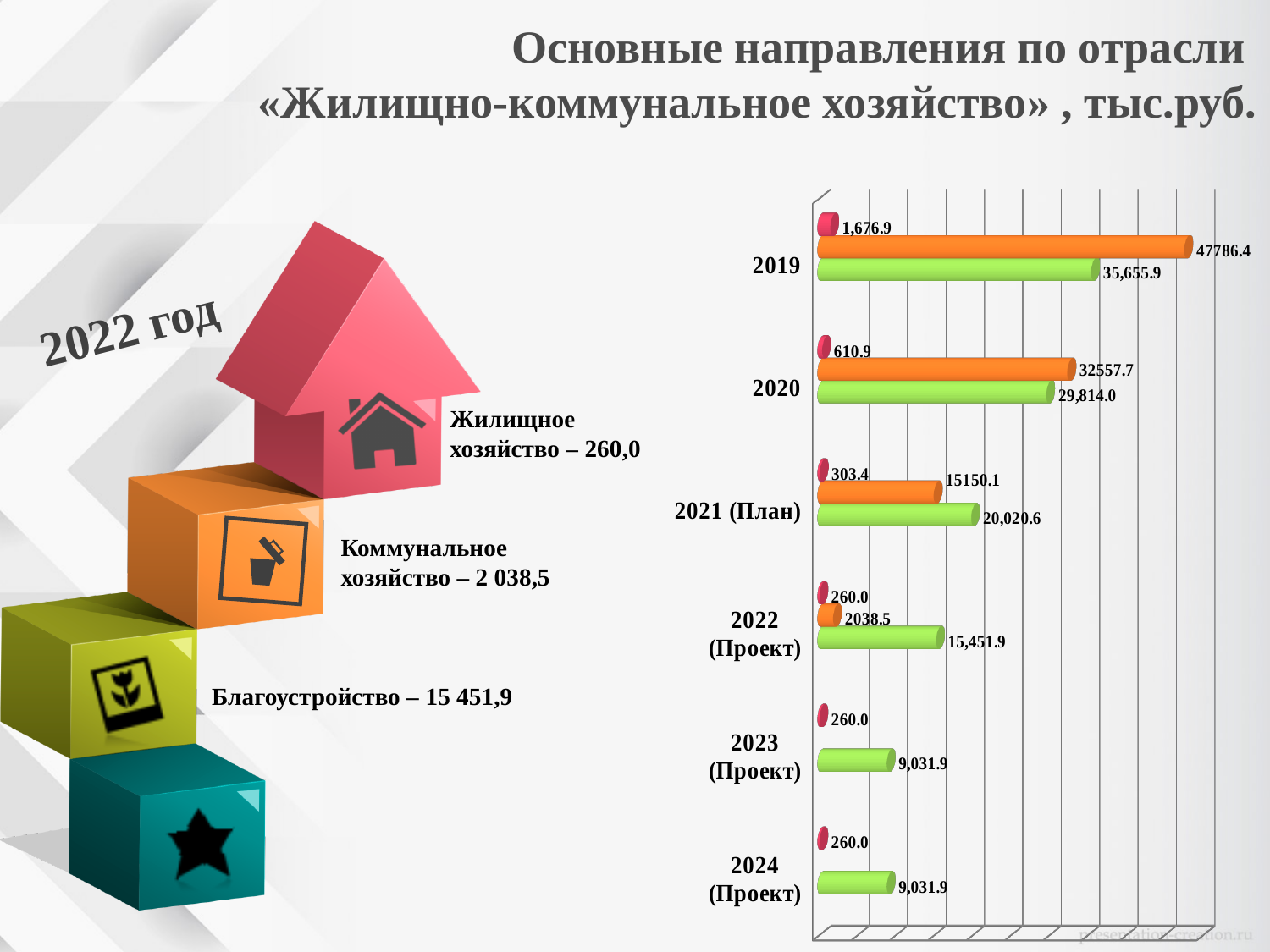
What is the value of the green bar for 2024 (Проект)? 9,031.9 What is the value of the orange bar for 2019? 47786.4 What type of chart is shown on the slide? bar chart In which year category is the orange bar the highest? 2019 In which year category is the pink bar the highest? 2019 What is the difference between the green bar and the orange bar for 2022 (Проект)? 13,413.4 Which year categories have no orange bar? 2023 (Проект) and 2024 (Проект) Which is larger for 2021 (План), the orange bar or the green bar? the green bar Do the green bar values rise or fall from 2019 to 2024 (Проект)? fall What is the value of the pink bar for 2021 (План)? 303.4 How many year categories are shown on the chart? 6 What is the value of the green bar for 2020? 29,814.0